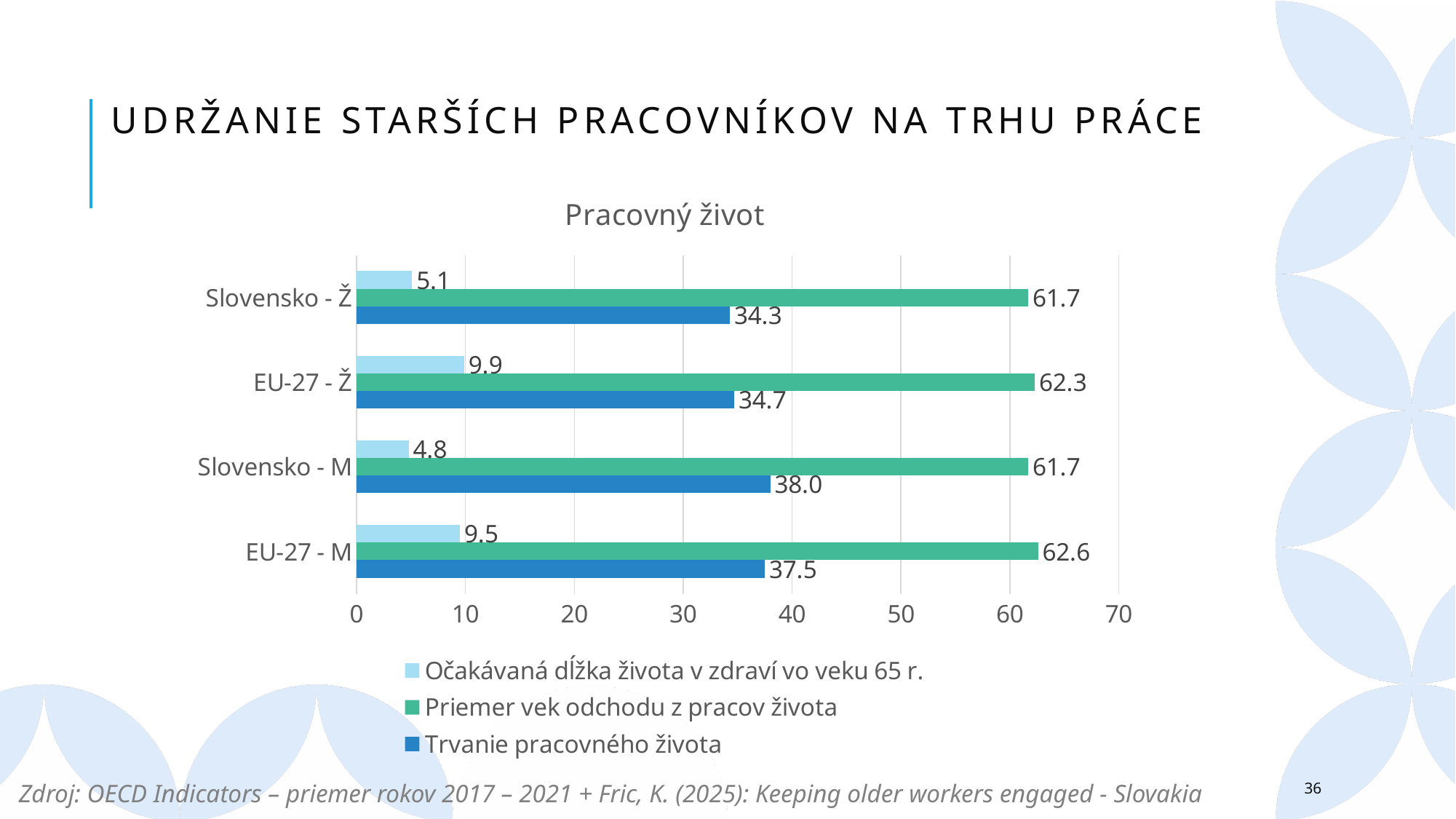
What is the title of the chart? Pracovný život What is the value of 'Očakávaná dĺžka života v zdraví vo veku 65 r.' for EU-27 - Ž? 9.9 Which category has the highest value for 'Trvanie pracovného života'? Slovensko - M How many categories are shown on the y axis of the chart? 4 Which is larger: 'Očakávaná dĺžka života v zdraví vo veku 65 r.' for EU-27 - M or for Slovensko - M? EU-27 - M Is the value of 'Trvanie pracovného života' for EU-27 - Ž greater or less than 40? less What is the value of 'Trvanie pracovného života' for Slovensko - M? 38.0 What is the value of 'Priemer vek odchodu z pracov života' for EU-27 - M? 62.6 What is the difference between the 'Trvanie pracovného života' values for Slovensko - M and Slovensko - Ž? 3.7 How many series does the legend list? 3 Which category has the lowest value for 'Očakávaná dĺžka života v zdraví vo veku 65 r.'? Slovensko - M What kind of chart is shown on the slide? bar chart